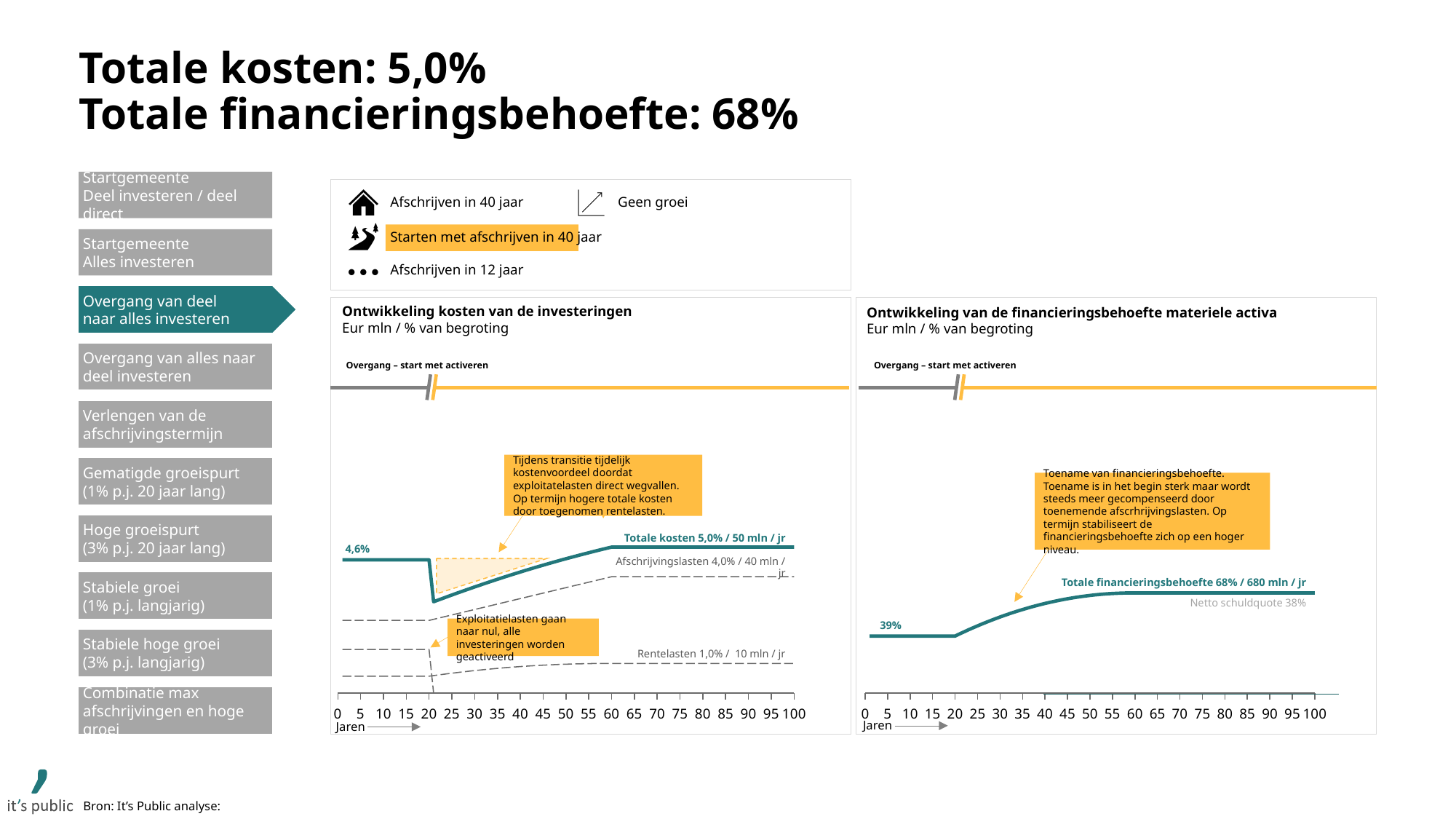
In the chart 'Ontwikkeling van de financieringsbehoefte materiele activa', what is the starting value of the line at year 0? 39% In the chart 'Ontwikkeling kosten van de investeringen', what value is labelled for 'Rentelasten'? 1,0% / 10 mln / jr What unit is given in the subtitle of the chart 'Ontwikkeling van de financieringsbehoefte materiele activa'? Eur mln / % van begroting In the chart 'Ontwikkeling van de financieringsbehoefte materiele activa', what value is labelled for 'Totale financieringsbehoefte'? 68% / 680 mln / jr In the chart 'Ontwikkeling kosten van de investeringen', what is the difference between the long-term total cost (5,0%) and the starting value (4,6%)? 0,4% In the chart 'Ontwikkeling kosten van de investeringen', what is the long-term value labelled for 'Totale kosten'? 5,0% / 50 mln / jr In the chart 'Ontwikkeling kosten van de investeringen', what value is labelled for 'Afschrijvingslasten'? 4,0% / 40 mln / jr What is the maximum value shown on the x axis of the chart 'Ontwikkeling kosten van de investeringen'? 100 In the chart 'Ontwikkeling van de financieringsbehoefte materiele activa', does the financing need line rise or fall after year 20? Rise In the chart 'Ontwikkeling van de financieringsbehoefte materiele activa', what is the labelled 'Netto schuldquote'? 38% In the chart 'Ontwikkeling kosten van de investeringen', what is the starting value of the total cost line at year 0? 4,6% What kind of chart is 'Ontwikkeling kosten van de investeringen'? Line chart